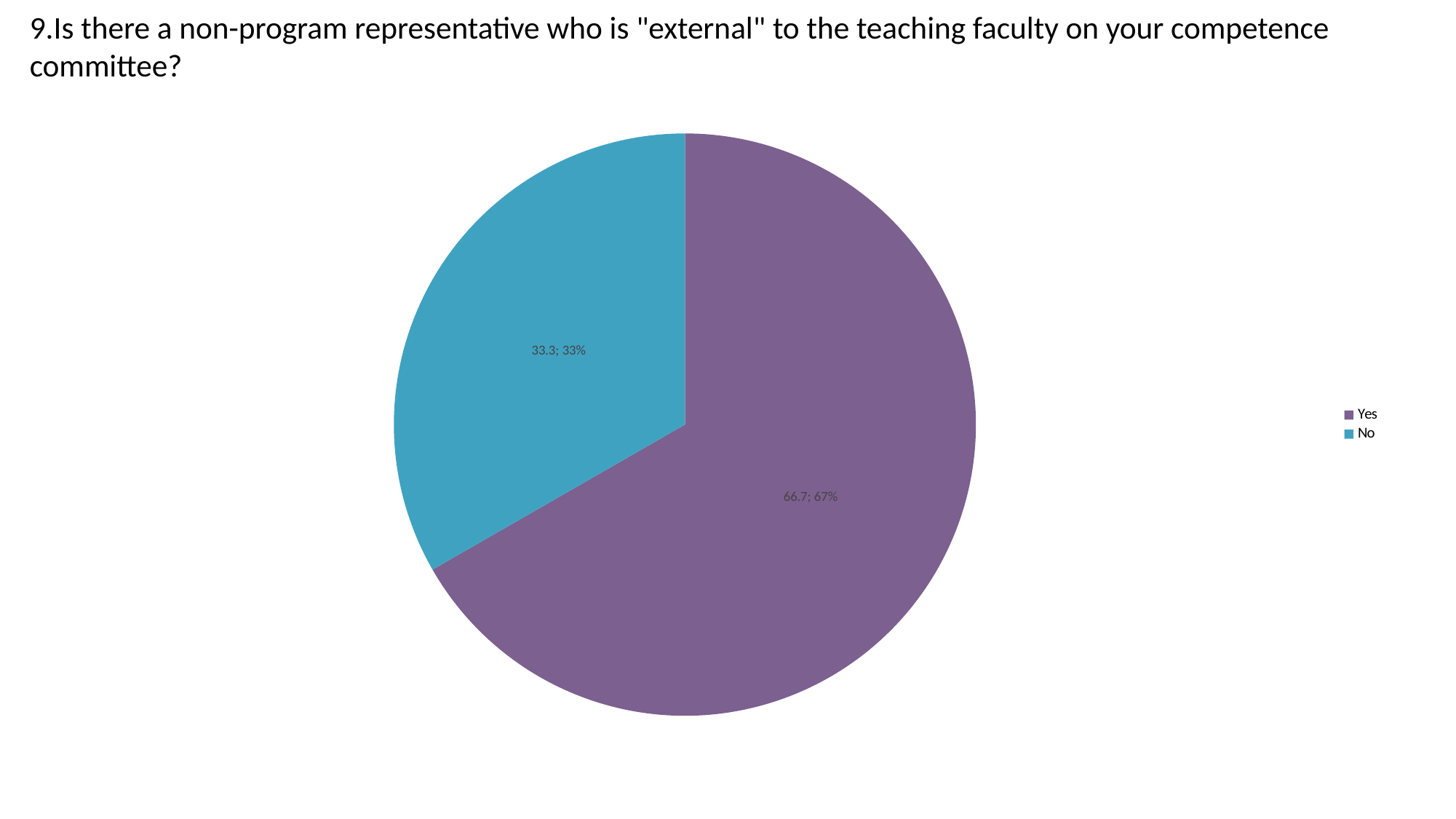
Which is larger, the Yes slice or the No slice? Yes Which slice is the largest? Yes What percentage share of the pie does the No slice represent? 33% How many slices does the pie chart have? 2 What colour is the Yes slice? purple How many entries does the legend list? 2 What value is shown for the Yes slice? 66.7 What kind of chart is shown on the slide? pie chart What is the difference between the Yes value and the No value? 33.4 What percentage share of the pie does the Yes slice represent? 67% Which slice is the smallest? No What value is shown for the No slice? 33.3